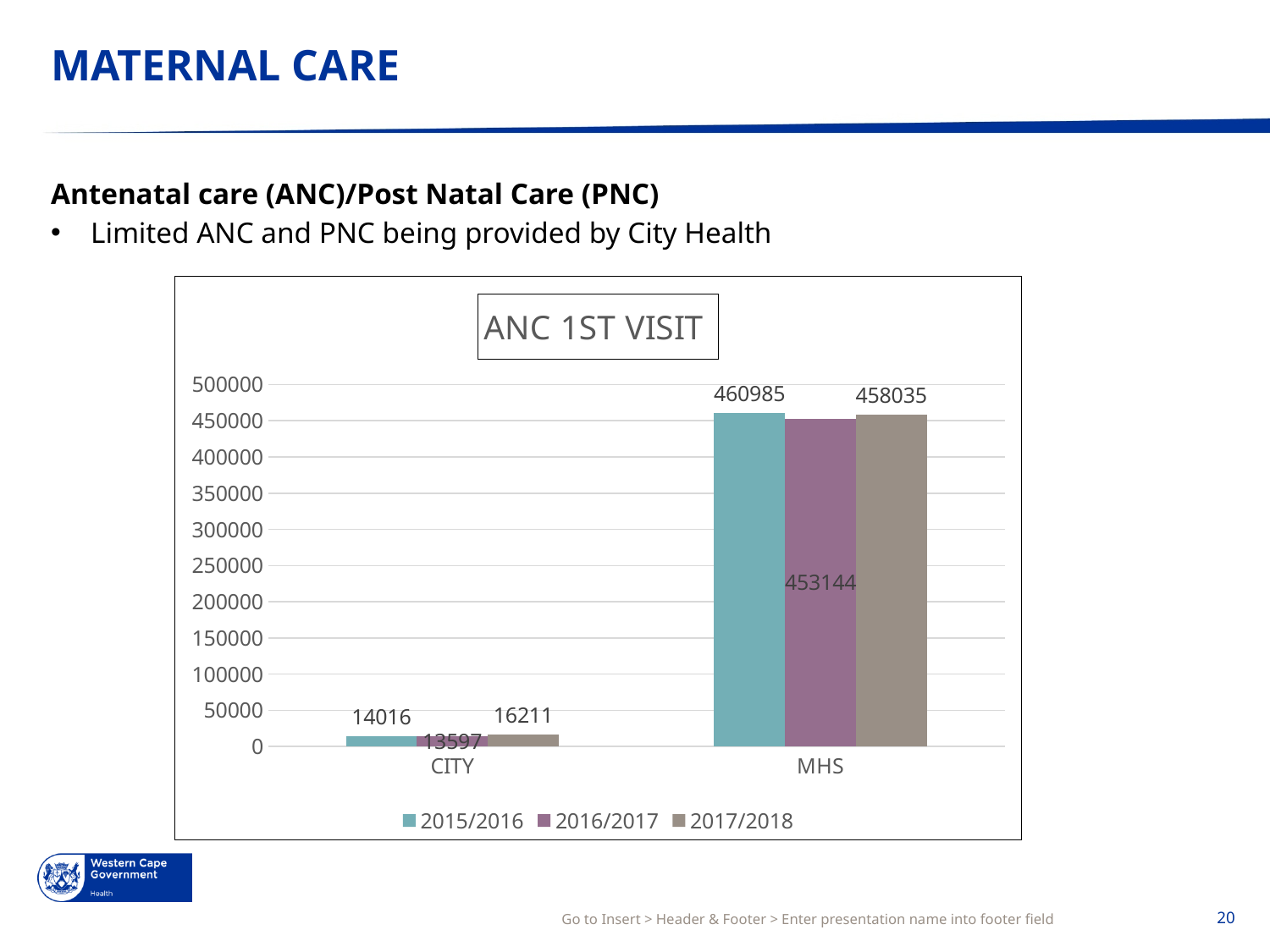
What is the title of the chart? ANC 1ST VISIT Which category has the lowest value in the 2016/2017 series? CITY What is the value for MHS in the 2016/2017 series? 453144 How many categories are shown on the x axis? 2 What is the value for CITY in the 2015/2016 series? 14016 What is the value for MHS in the 2017/2018 series? 458035 Is the value for MHS in 2016/2017 greater or less than 400000? greater What is the value for CITY in the 2017/2018 series? 16211 Which category has the highest value in the 2015/2016 series? MHS Which is larger for MHS: the 2015/2016 value or the 2017/2018 value? 2015/2016 What is the difference between the 2015/2016 and 2017/2018 values for CITY? 2195 How many series does the legend list? 3